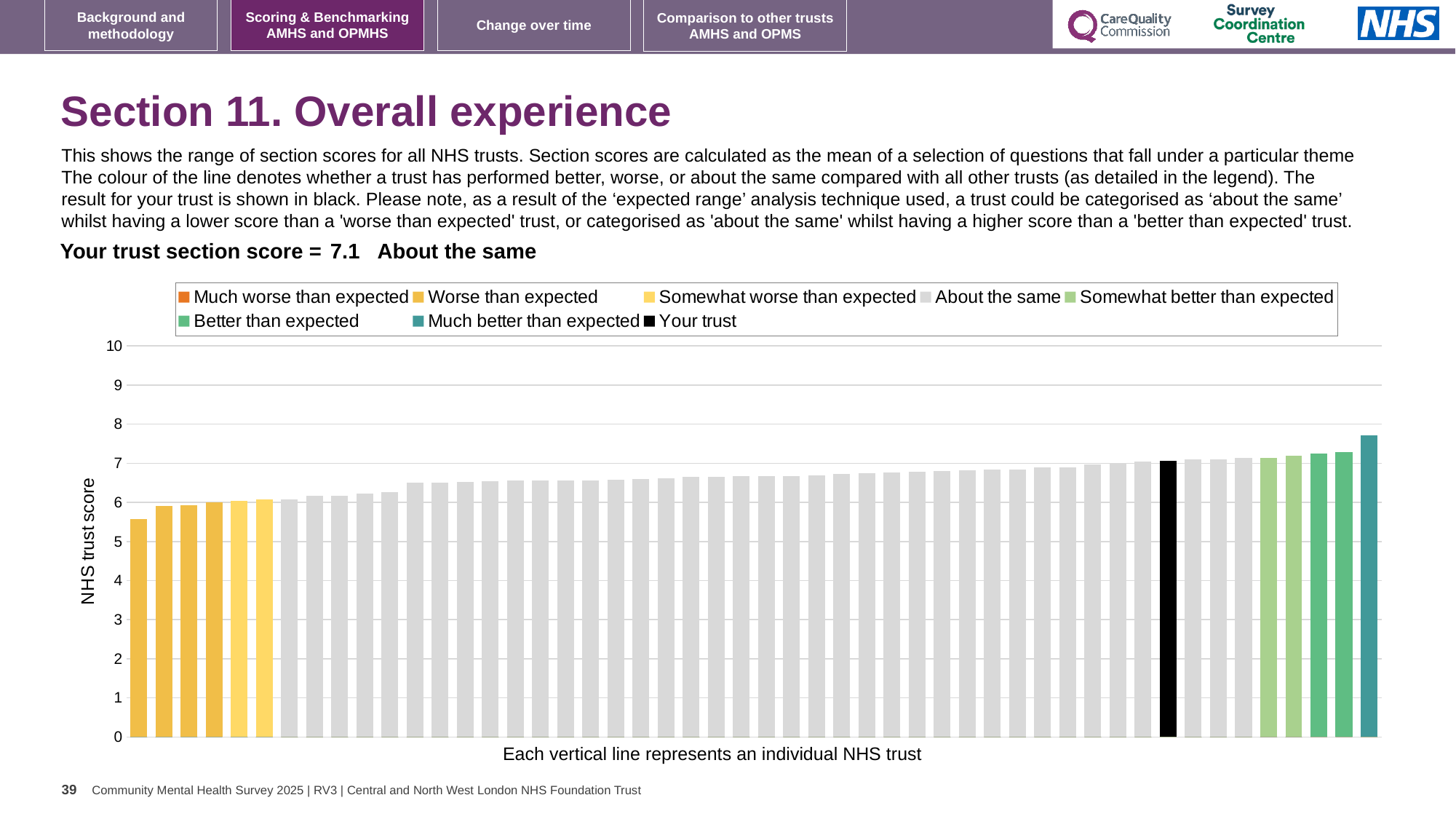
How many entries does the chart legend list? 8 Is the value of the tallest bar greater or less than 8? less Which legend category does the tallest bar belong to? Much better than expected Which category is your trust placed in for this section? About the same Is the value of the black 'Your trust' bar greater or less than 6? greater Do the bar values rise or fall from left to right along the x axis? Rise What is the label on the y axis of the chart? NHS trust score Is the value of the shortest bar greater or less than 6? less What is the section score for your trust, as stated on the slide? 7.1 What colour is the bar representing your trust? Black Which legend category does the shortest bar belong to? Worse than expected What kind of chart is shown on the slide? Bar chart